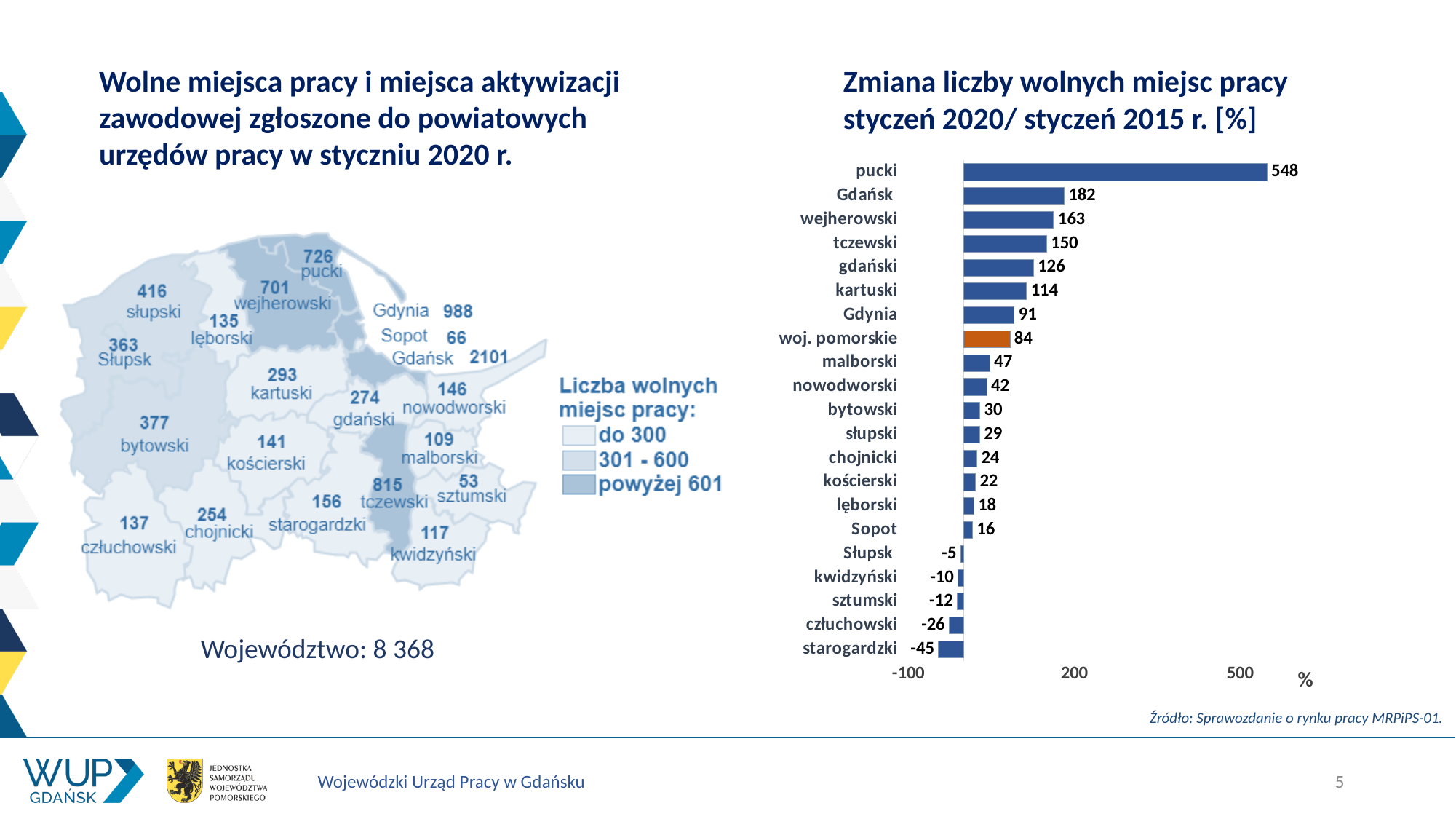
In the bar chart, which category's bar is coloured orange instead of blue? woj. pomorskie What kind of chart is shown on the right side of the slide? bar chart What is the title of the bar chart? Zmiana liczby wolnych miejsc pracy styczeń 2020/ styczeń 2015 r. [%] In the bar chart, what is the value for woj. pomorskie? 84 Which category has the highest value in the bar chart? pucki In the bar chart, what is the value for pucki? 548 In the bar chart, is the value for wejherowski greater or less than 200? less Which category has the lowest value in the bar chart? starogardzki In the bar chart, which is larger: the value for tczewski or the value for kartuski? tczewski In the bar chart, what is the difference between the values for Gdańsk and Gdynia? 91 In the bar chart, what is the value for starogardzki? -45 How many categories are shown in the bar chart? 21